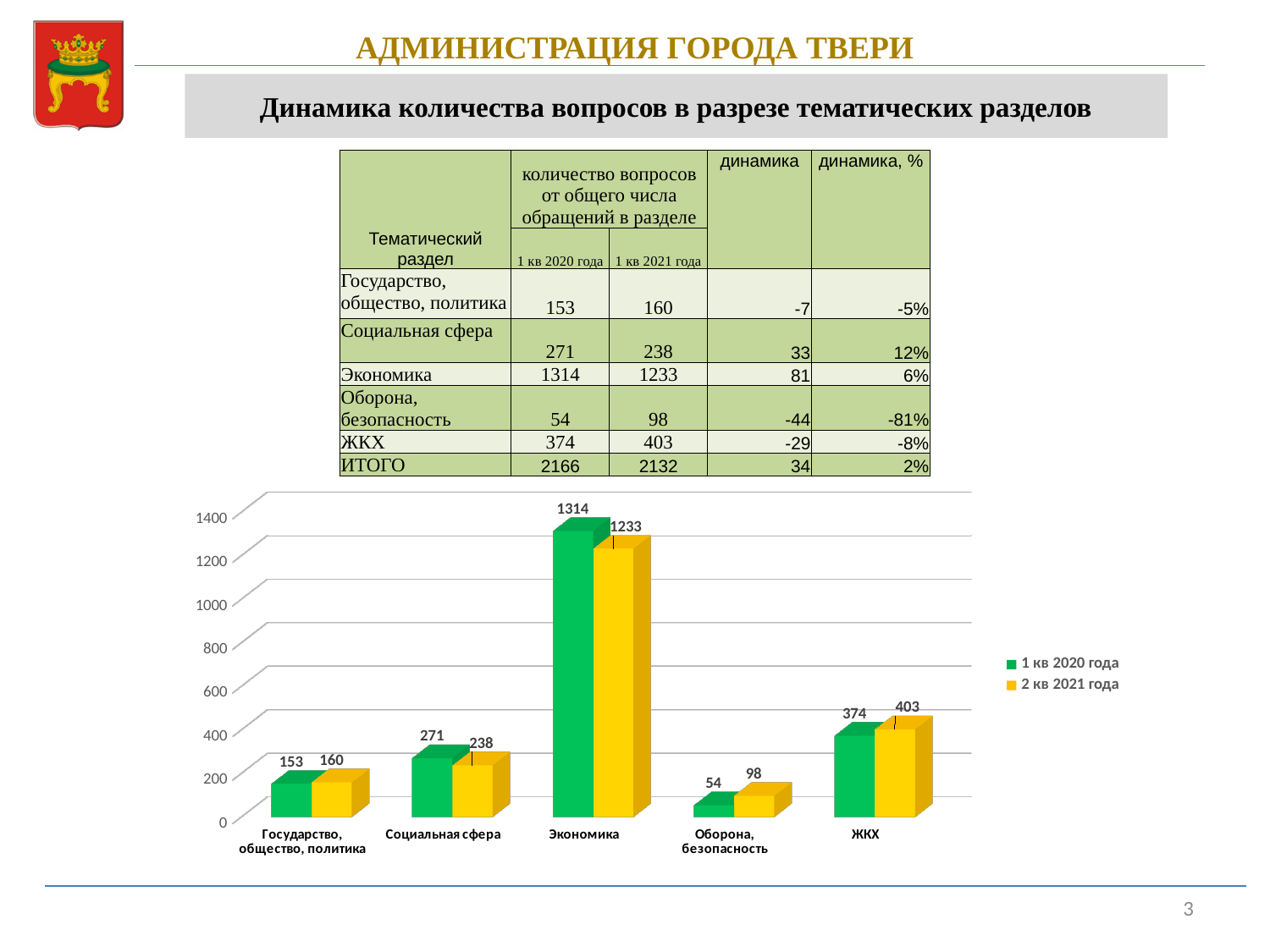
What is the value for Экономика in the 1 кв 2020 года series? 1314 What is the value for Оборона, безопасность in the 1 кв 2020 года series? 54 Which category has the lowest value in the 2 кв 2021 года series? Оборона, безопасность How many series does the chart legend list? 2 Is the value for ЖКХ in the 1 кв 2020 года series greater or less than 400? less What is the difference between the 1 кв 2020 года and 2 кв 2021 года values for Социальная сфера? 33 For Государство, общество, политика, which series has the larger value: 1 кв 2020 года or 2 кв 2021 года? 2 кв 2021 года Which colour represents the 2 кв 2021 года series in the chart? yellow How many categories are shown on the x axis of the chart? 5 What is the value for ЖКХ in the 2 кв 2021 года series? 403 Which category has the highest value in the 1 кв 2020 года series? Экономика What kind of chart is shown on the slide? bar chart